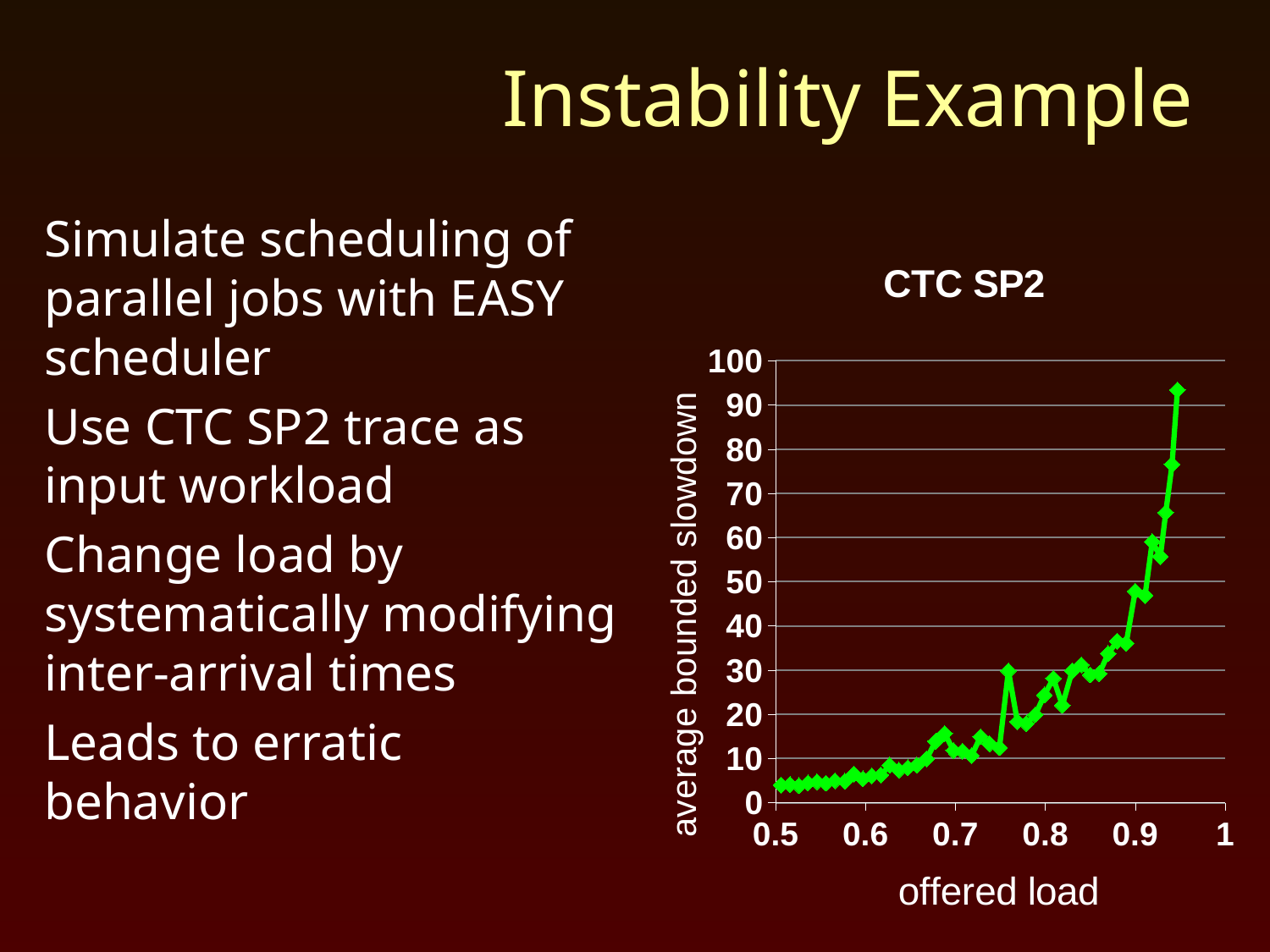
What kind of chart is shown on the slide? line chart Is the average bounded slowdown at an offered load of 0.5 greater or less than 10? less Is the highest average bounded slowdown plotted greater or less than 80? greater Which has the larger average bounded slowdown: an offered load of 0.6 or an offered load of 0.9? 0.9 What is the label of the x axis of the chart? offered load Does the average bounded slowdown generally rise or fall as offered load increases from 0.5 to 1? rise Is the lowest average bounded slowdown found near an offered load of 0.5 or near 0.9? 0.5 Is the average bounded slowdown at an offered load of 0.7 greater or less than 20? less What is the highest value shown on the y axis of the chart? 100 What is the title of the chart? CTC SP2 Is the highest point on the chart near the left end or the right end of the offered load axis? right end